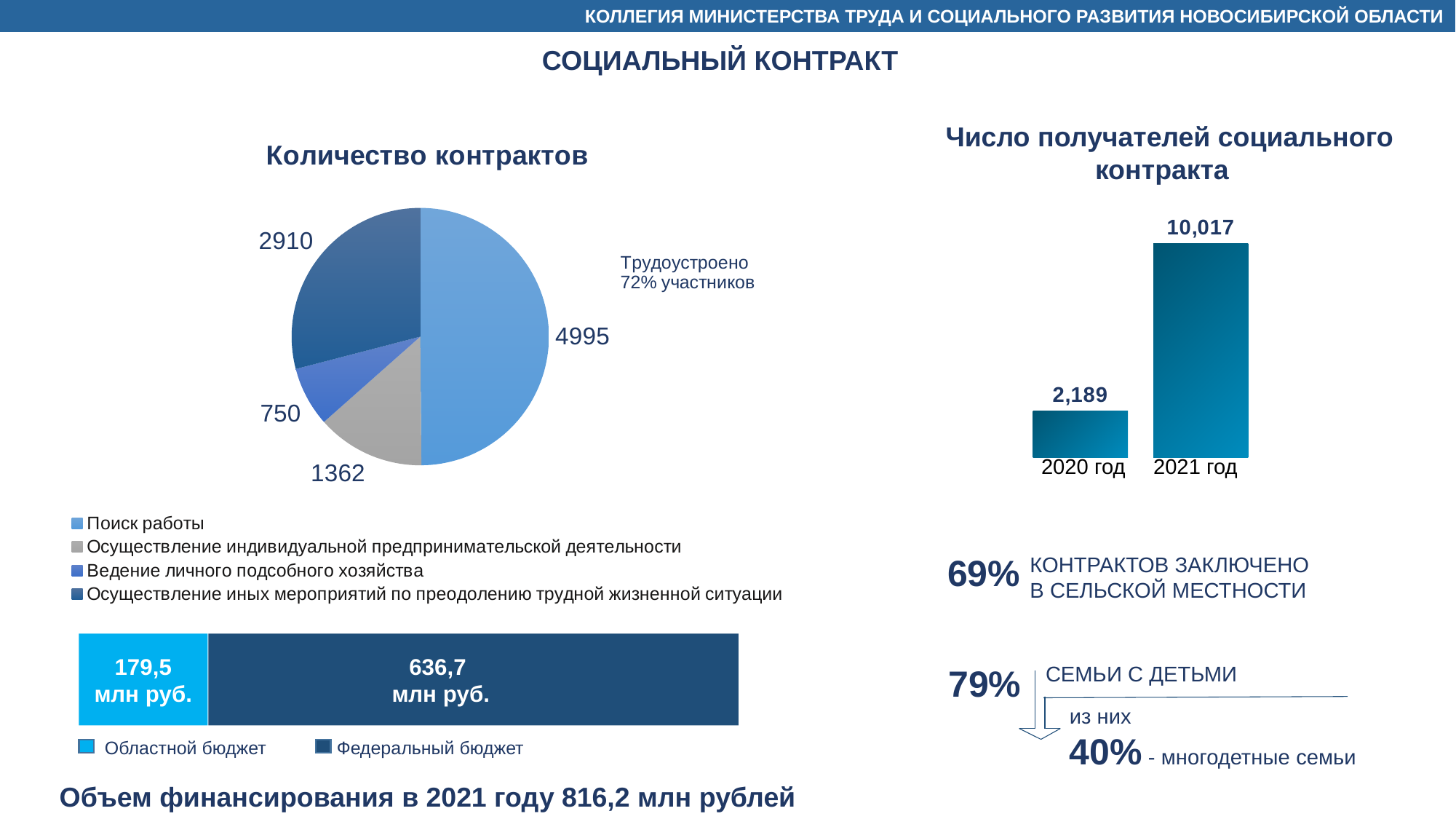
In the stacked funding bar at the bottom left, which is larger: 'Областной бюджет' or 'Федеральный бюджет'? Федеральный бюджет In the chart 'Число получателей социального контракта', do the values rise or fall from 2020 год to 2021 год? rise In the pie chart 'Количество контрактов', which category has the smallest value? Ведение личного подсобного хозяйства In the chart 'Число получателей социального контракта', what is the value for 2020 год? 2,189 In the chart 'Число получателей социального контракта', what is the value for 2021 год? 10,017 In the pie chart 'Количество контрактов', which category has the largest value? Поиск работы In the pie chart 'Количество контрактов', what is the value for 'Поиск работы'? 4995 How many categories does the legend of the pie chart 'Количество контрактов' list? 4 In the pie chart 'Количество контрактов', what is the value for 'Ведение личного подсобного хозяйства'? 750 What kind of chart is 'Число получателей социального контракта'? bar chart In the pie chart 'Количество контрактов', what is the difference between 'Осуществление иных мероприятий по преодолению трудной жизненной ситуации' and 'Осуществление индивидуальной предпринимательской деятельности'? 1548 In the stacked funding bar at the bottom left, what is the value for 'Федеральный бюджет'? 636,7 млн руб.